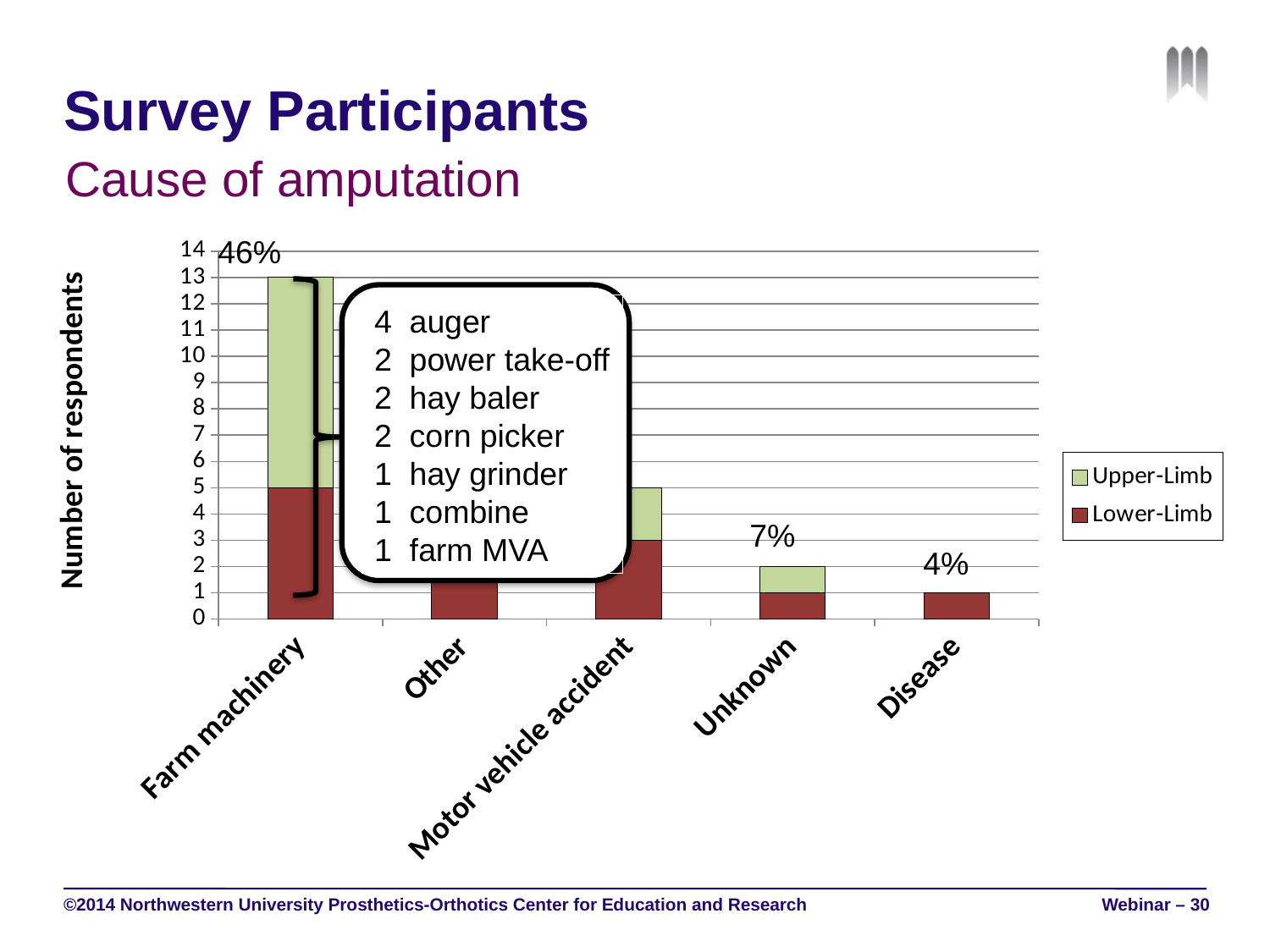
What percentage label is shown above the Unknown bar? 7% How many cause-of-amputation categories are shown on the x axis? 5 What percentage label is shown above the Disease bar? 4% Which cause of amputation has the lowest number of respondents? Disease What kind of chart is shown on the slide? Stacked bar chart Is the total number of respondents for Farm machinery greater or less than 10? greater How many Lower-Limb respondents are in the Farm machinery category? 5 What percentage label is shown for Farm machinery? 46% What is the total number of respondents for Farm machinery? 13 How many series does the legend list? 2 Which cause of amputation has the highest number of respondents? Farm machinery Which has more respondents, Unknown or Disease? Unknown